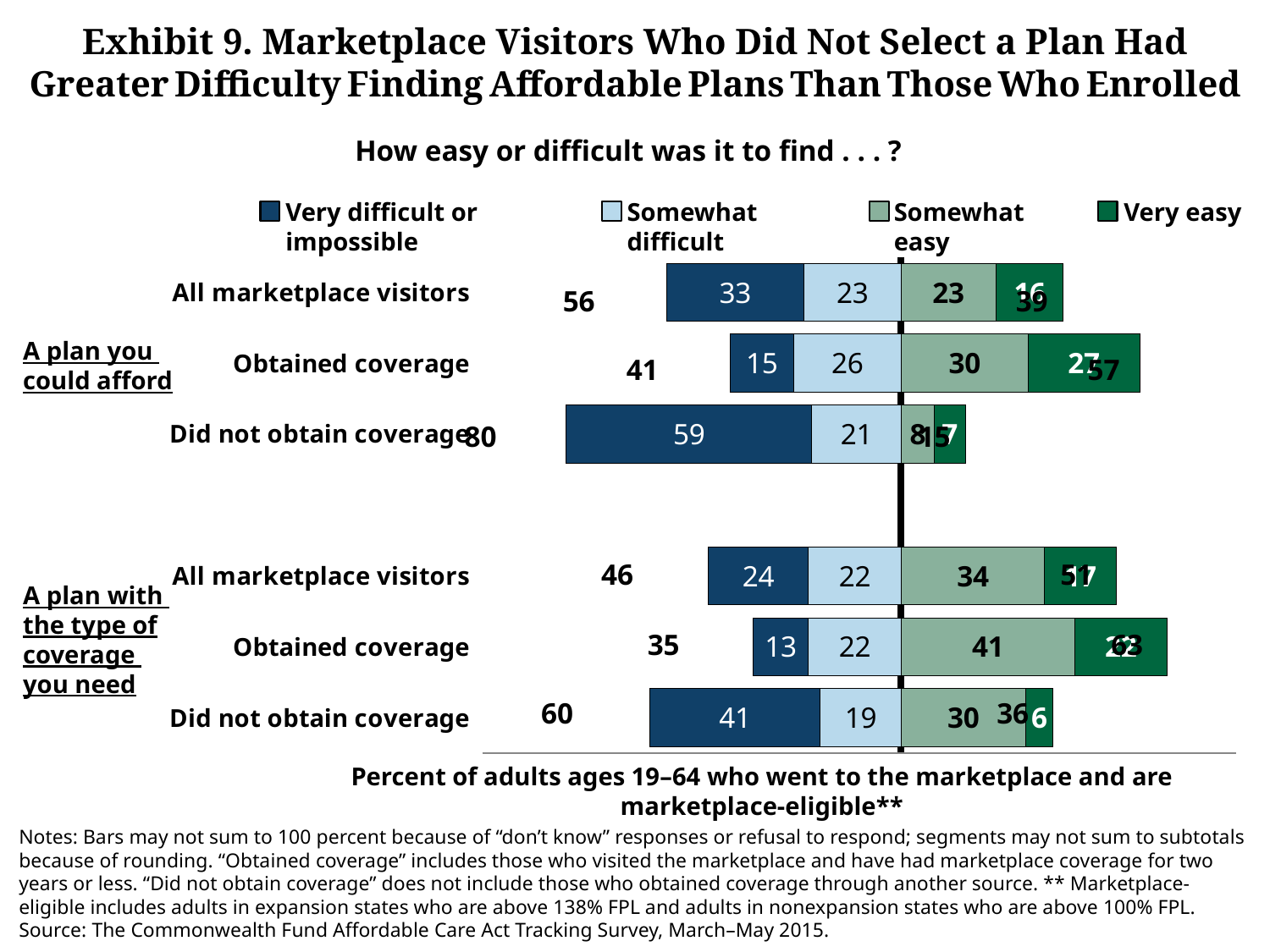
How many series does the legend list? 4 For a plan you could afford, what is the combined 'very difficult or impossible' plus 'somewhat difficult' subtotal shown for those who did not obtain coverage? 80 For a plan with the type of coverage you need, what percentage of those who did not obtain coverage said it was very easy? 6 Which colour represents 'Very easy' in the legend? Dark green What kind of chart is shown on the slide? Bar chart For a plan you could afford, what is the difference in the 'very difficult or impossible' value between those who did not obtain coverage and those who obtained coverage? 44 What percentage of marketplace visitors who did not obtain coverage said it was very difficult or impossible to find a plan they could afford? 59 For a plan with the type of coverage you need, which group has the lowest 'very difficult or impossible' value? Obtained coverage For a plan you could afford, which group has the highest 'very difficult or impossible' value? Did not obtain coverage For a plan with the type of coverage you need, what percentage of those who obtained coverage said it was somewhat easy? 41 For a plan you could afford, which has the larger 'somewhat difficult' value: all marketplace visitors or those who obtained coverage? Obtained coverage How many stacked bars are plotted in the chart? 6